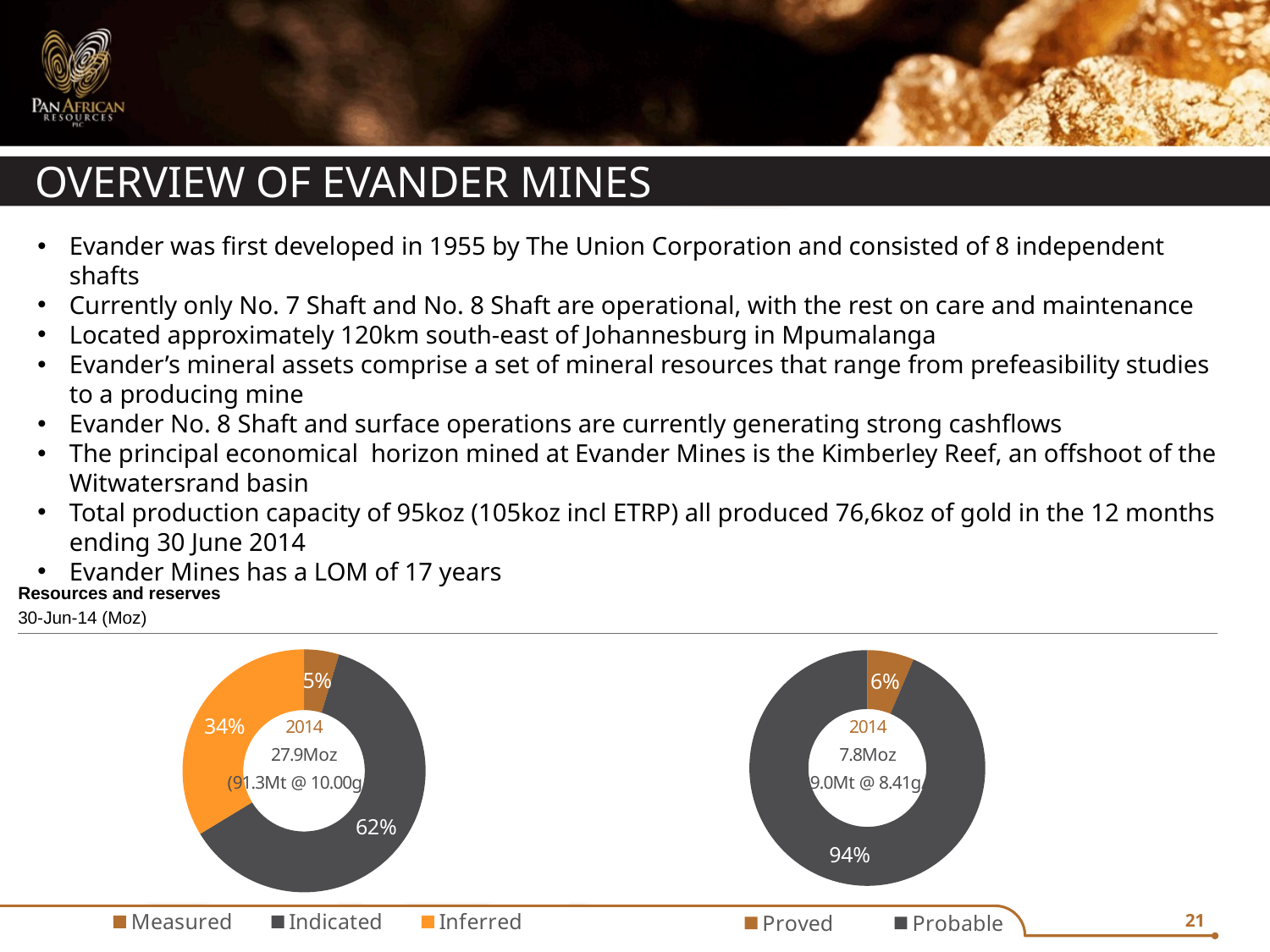
In the left chart, what percentage is shown for Indicated? 62% In the left chart, which category has the largest share? Indicated In the right chart, which is larger, Proved or Probable? Probable In the left chart, what percentage is shown for Measured? 5% How many categories does the legend of the left chart list? 3 In the left chart, which category has the smallest share? Measured In the left chart, what percentage is shown for Inferred? 34% What type of chart is the left chart on the slide? Pie chart (donut) In the right chart, what percentage is shown for Probable? 94% In the left chart, what is the difference in percentage points between Indicated and Inferred? 28 In the right chart, what percentage is shown for Proved? 6% What total value in Moz is shown in the centre of the right chart? 7.8Moz